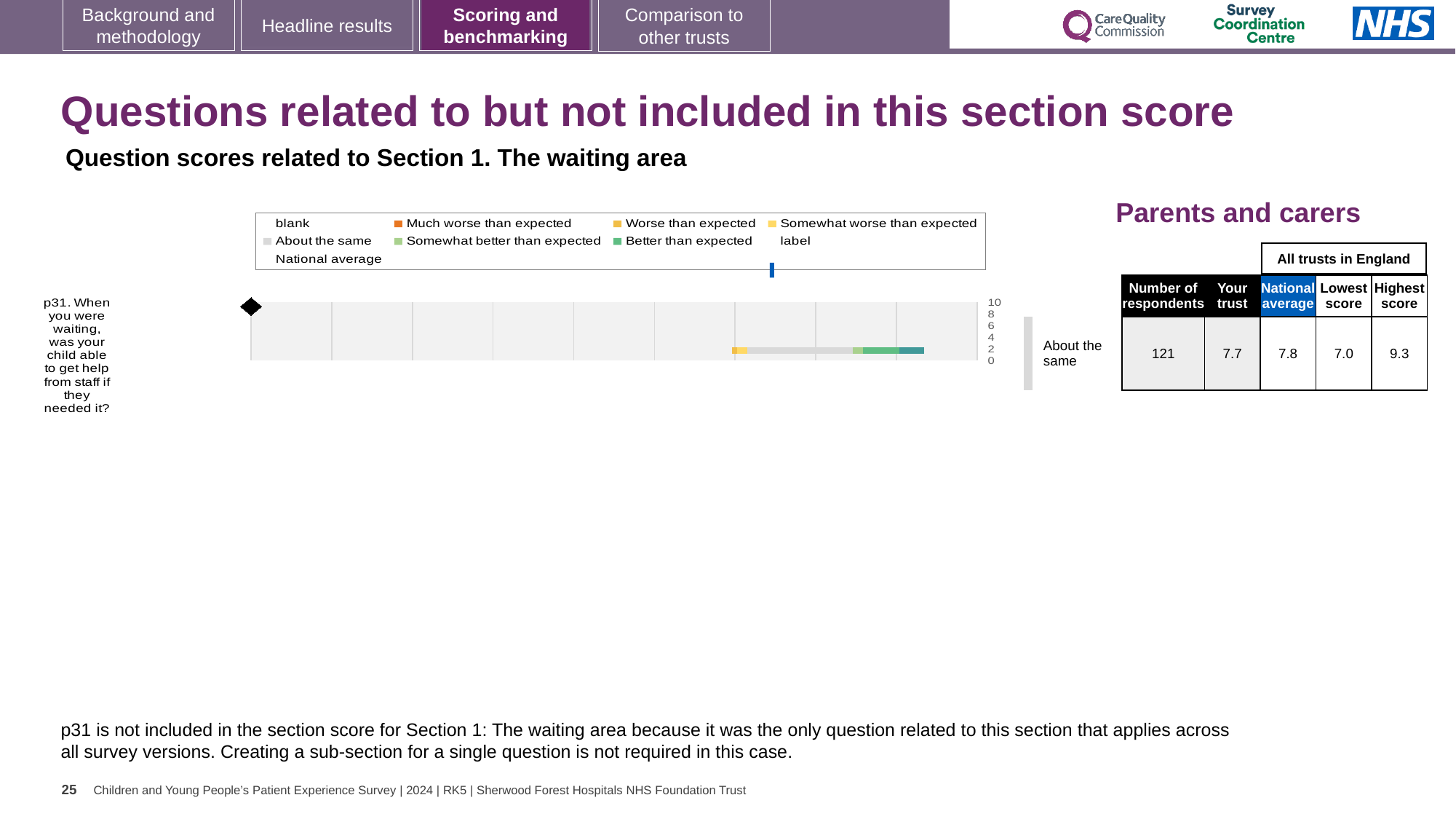
What is the difference between the National average and the 'Your trust' score for p31? 0.1 What kind of chart is shown for question p31? bar chart How many survey questions are plotted in the chart? 1 In the Parents and carers table, what is the National average score for p31? 7.8 Which survey question is plotted in the chart? p31. When you were waiting, was your child able to get help from staff if they needed it? What is the difference between the Highest score and the Lowest score for p31? 2.3 Which is larger for p31, the 'Your trust' score or the National average? National average What category label is shown to the right of the bar for p31? About the same In the Parents and carers table, what is the Lowest score across all trusts in England for p31? 7.0 In the Parents and carers table, what is the 'Your trust' score for p31? 7.7 In the Parents and carers table, how many respondents answered p31? 121 In the Parents and carers table, what is the Highest score across all trusts in England for p31? 9.3